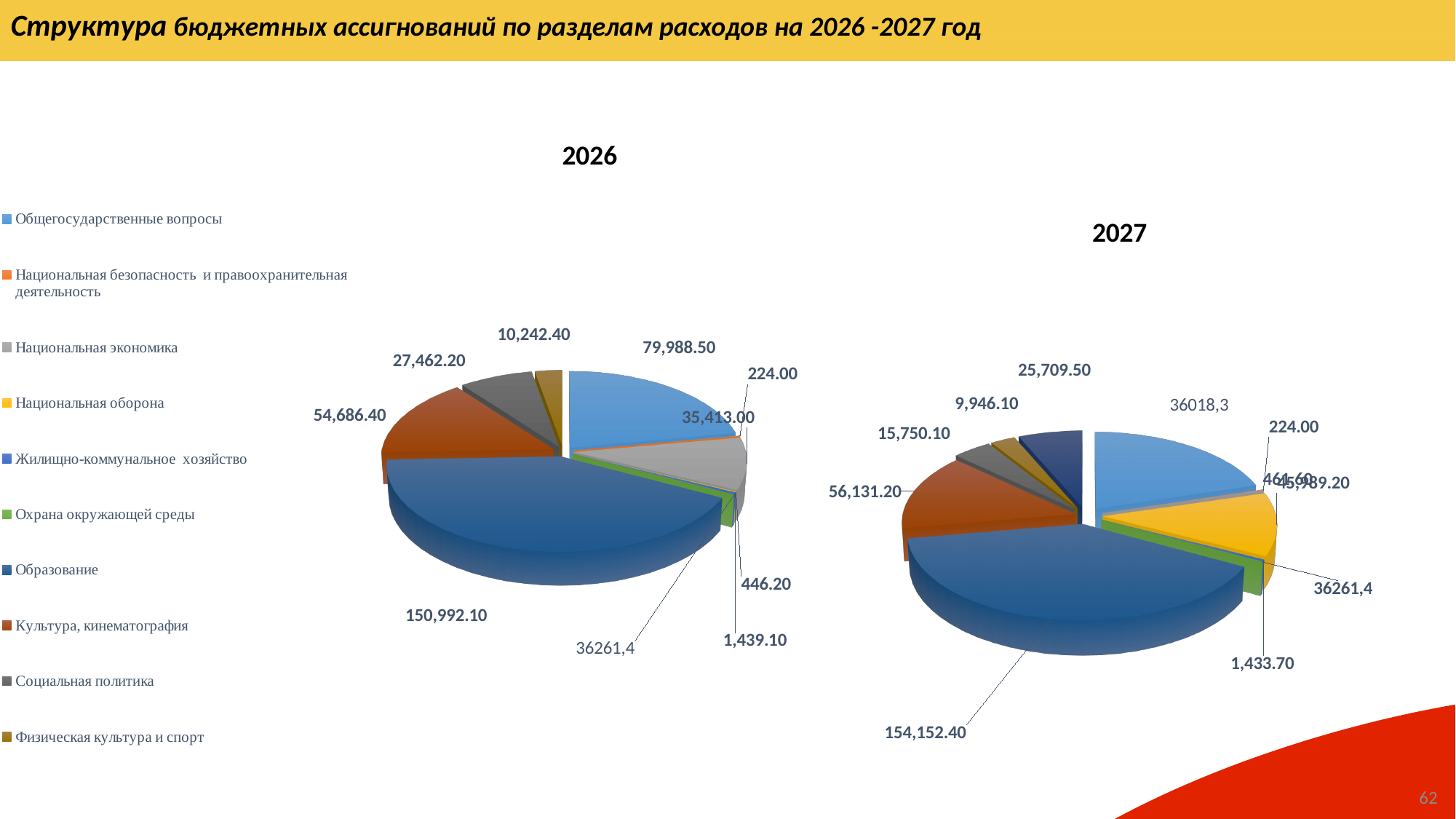
In the 2026 chart, what is the value for Культура, кинематография? 54,686.40 In the 2026 chart, what is the value for Образование? 150,992.10 In the 2026 chart, what is the smallest labelled value? 224.00 In the 2026 chart, what is the value for Физическая культура и спорт? 10,242.40 How many categories does the legend list for the charts? 10 In the 2026 chart, which is larger: Культура, кинематография or Социальная политика? Культура, кинематография In the 2026 chart, which category has the largest slice? Образование What kind of chart is used for the 2026 data on the slide? Pie chart